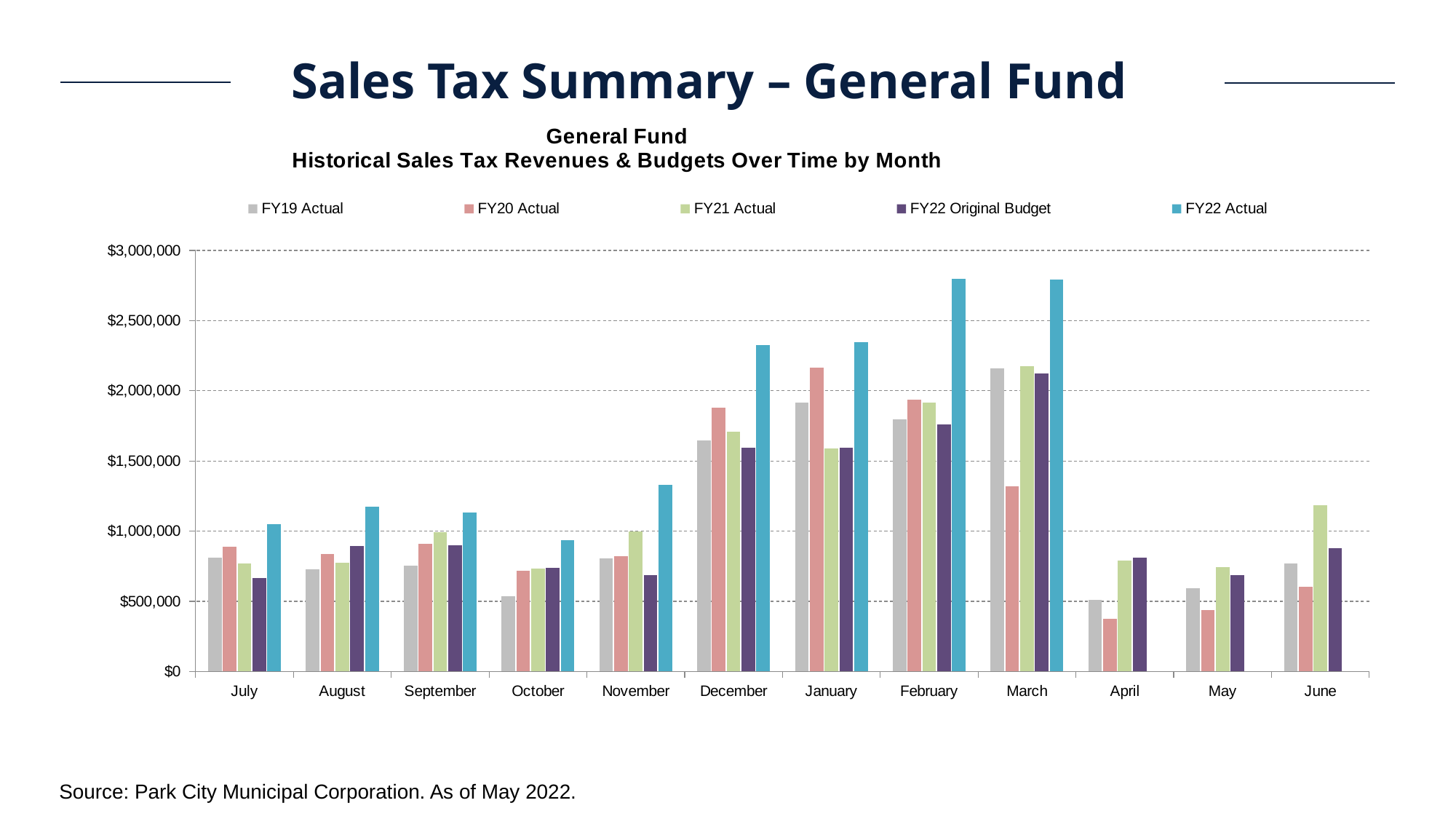
How many months are shown along the x axis? 12 Is the FY22 Actual value for December greater or less than $2,000,000? greater Which month has the highest FY22 Original Budget value? March What is the title printed above the chart? General Fund Historical Sales Tax Revenues & Budgets Over Time by Month Which month has the lowest FY20 Actual value? April How many series does the legend list? 5 Which month has the highest FY19 Actual value? March Which month has the highest FY20 Actual value? January Does the FY22 Actual value rise or fall from November to February? Rise Is the FY21 Actual value for June greater or less than $1,000,000? greater In April, which is larger: FY21 Actual or FY20 Actual? FY21 Actual What kind of chart is shown on the slide? Bar chart